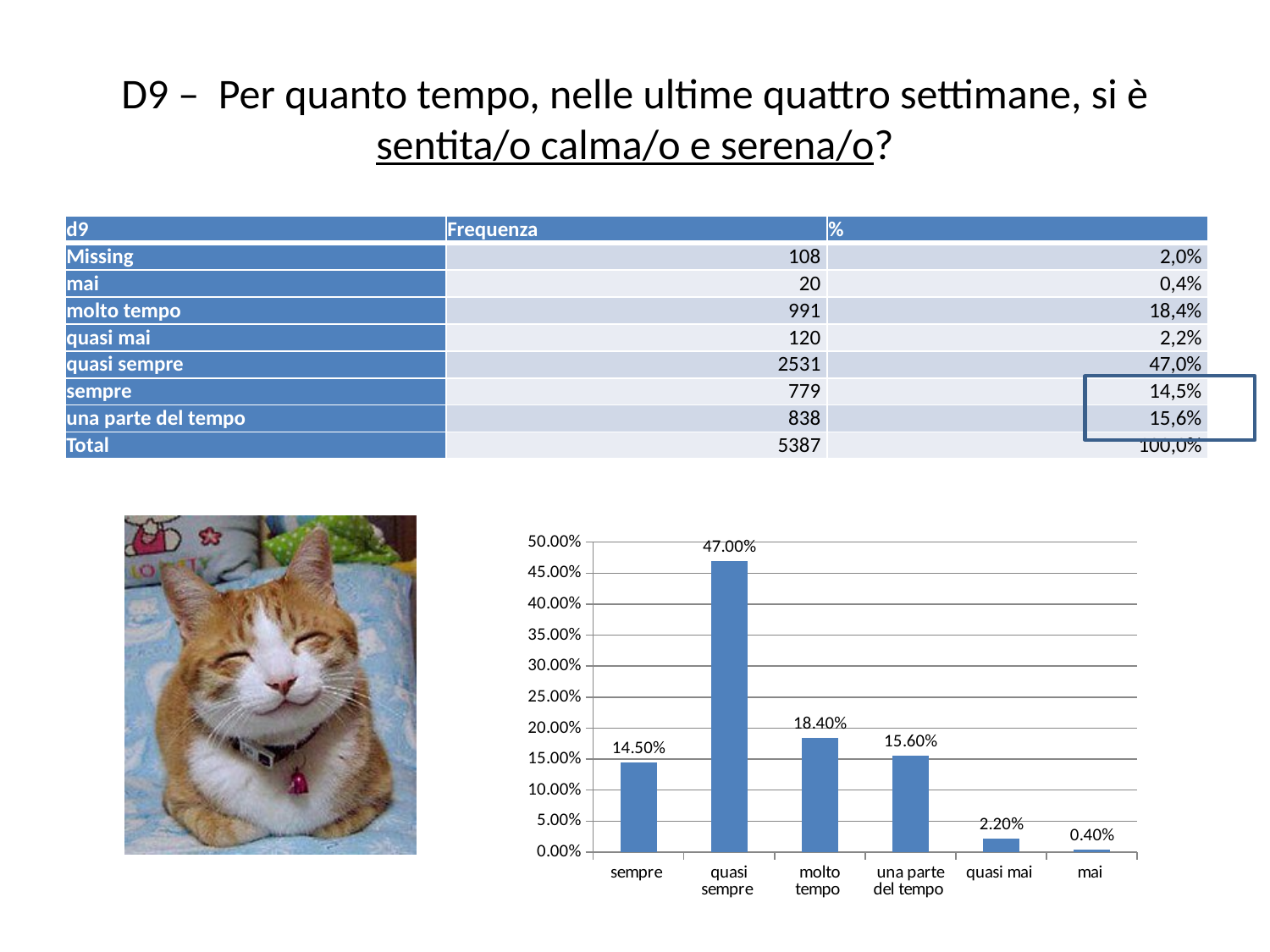
How many categories are plotted in the bar chart? 6 What is the difference between the values for "quasi sempre" and "molto tempo" in the bar chart? 28.60% Which is larger in the bar chart, the value for "molto tempo" or the value for "una parte del tempo"? molto tempo What is the difference between the values for "quasi mai" and "mai" in the bar chart? 1.80% What is the value shown for "una parte del tempo" in the bar chart? 15.60% Is the value for "quasi mai" in the bar chart greater or less than 5.00%? less Which category has the lowest value in the bar chart? mai What is the value shown for "quasi sempre" in the bar chart? 47.00% Which category has the highest value in the bar chart? quasi sempre What is the value shown for "mai" in the bar chart? 0.40% What is the value shown for "sempre" in the bar chart? 14.50% What kind of chart is shown on the slide? bar chart